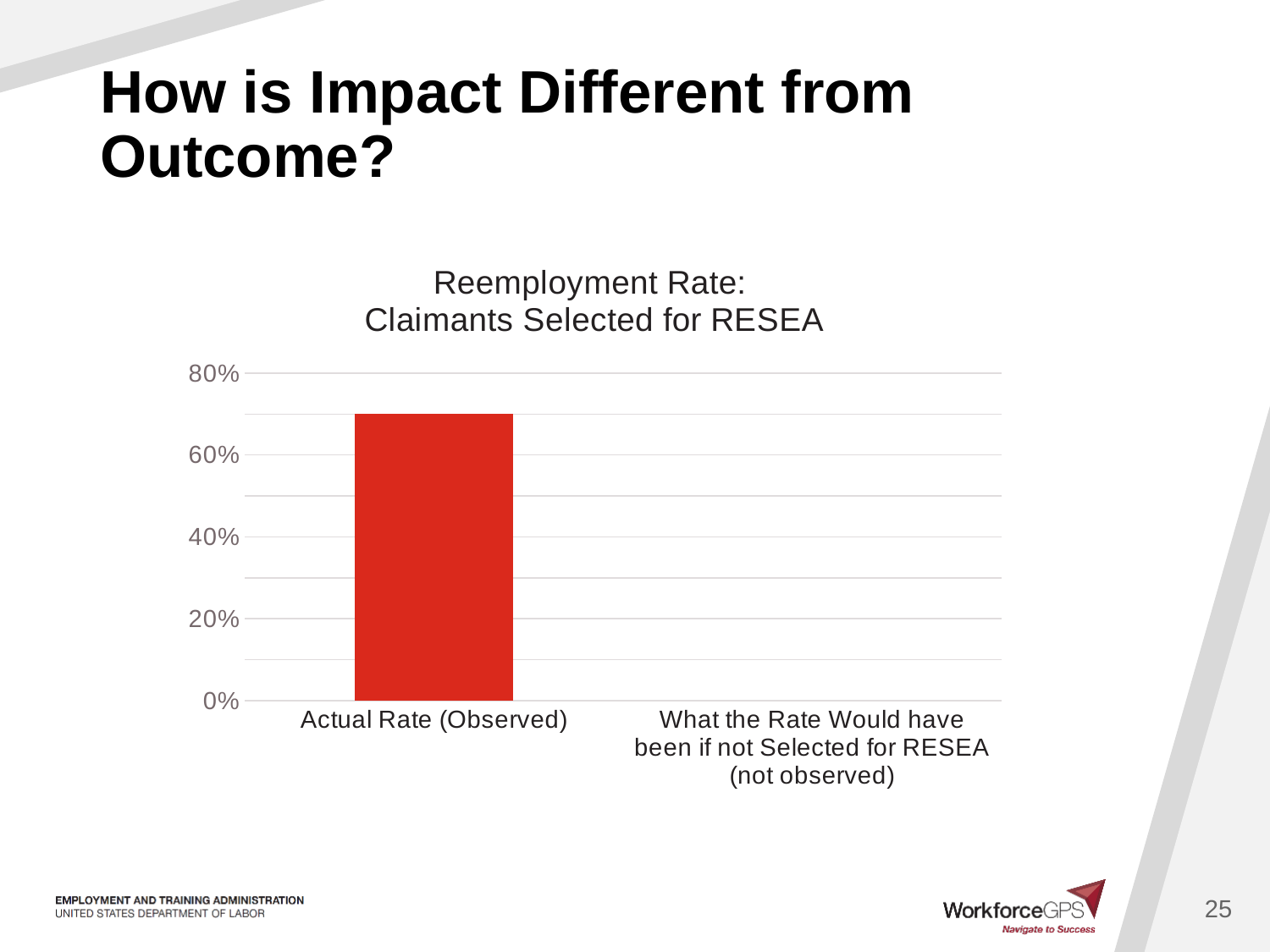
Which category has a bar plotted in the chart? Actual Rate (Observed) Is the value for Actual Rate (Observed) greater or less than 80%? less Is the value for Actual Rate (Observed) greater or less than 40%? greater What is the label of the second category on the x axis? What the Rate Would have been if not Selected for RESEA (not observed) What is the highest value shown on the y axis of the chart? 80% What kind of chart is shown on the slide? bar chart What is the title of the chart? Reemployment Rate: Claimants Selected for RESEA How many categories are shown on the x axis of the chart? 2 Is the value for Actual Rate (Observed) greater or less than 60%? greater